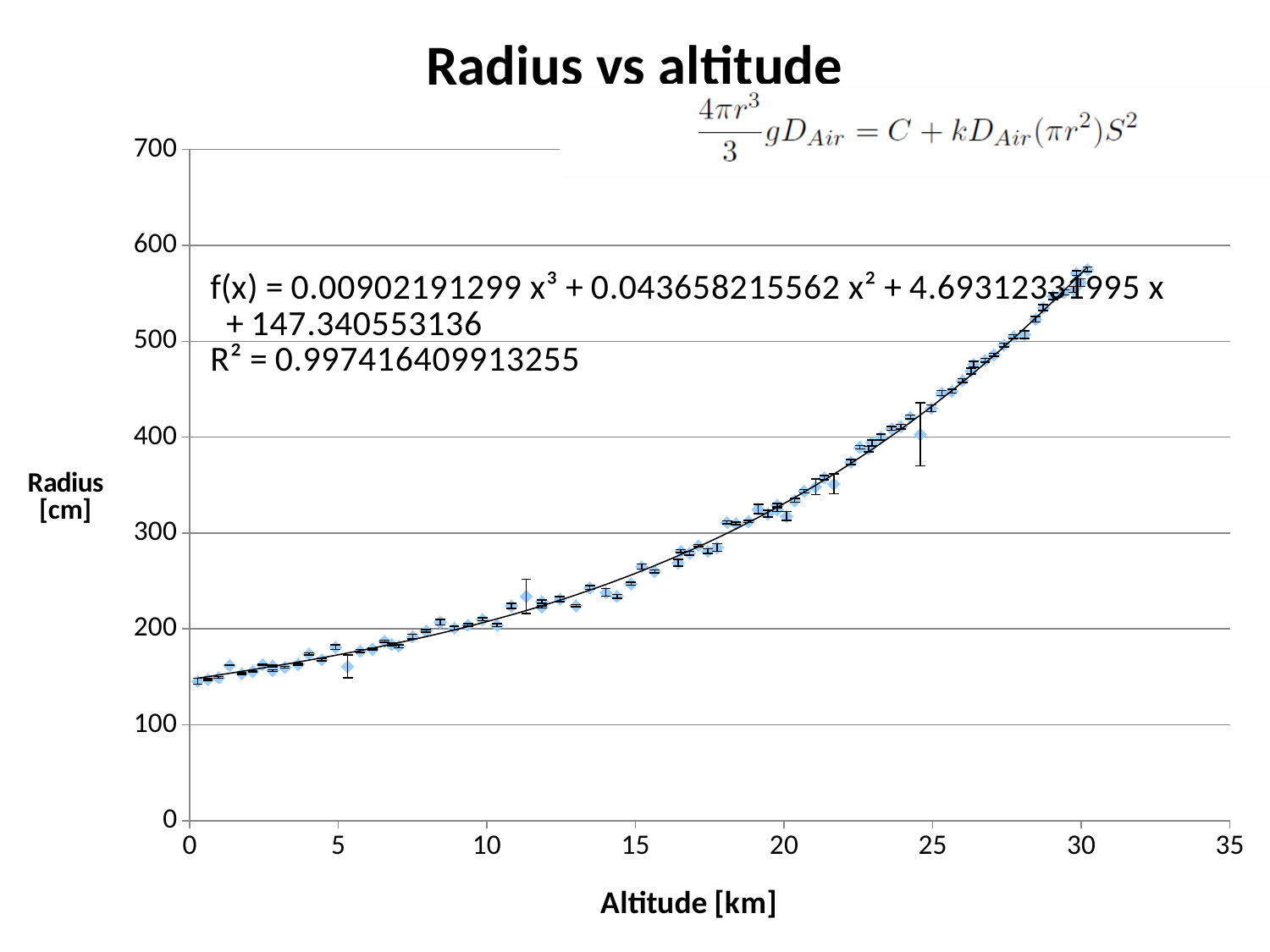
Is the radius at an altitude of 0 km greater or less than 100? greater What is the title of the chart? Radius vs altitude Is the radius at an altitude of 30 km greater or less than 500? greater What R² value is printed on the chart for the fitted curve? 0.997416409913255 Does the radius rise or fall as altitude increases along the x axis? rise Which is larger, the radius at 30 km altitude or the radius at 10 km altitude? 30 km Is the radius at an altitude of 5 km greater or less than 200? less What kind of chart is shown on the slide? scatter chart